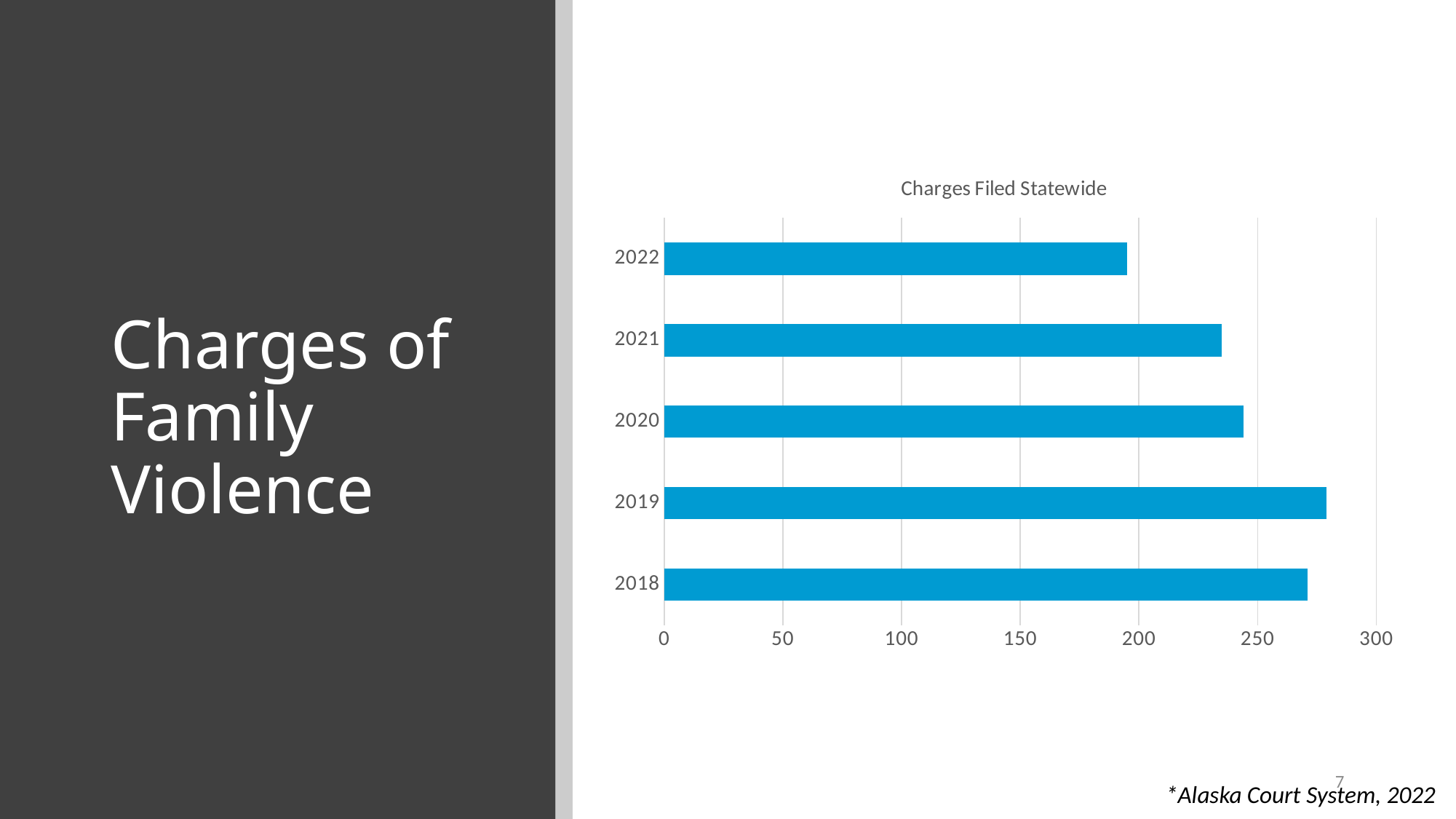
Which year has more charges filed, 2018 or 2021? 2018 Do the charges filed statewide generally rise or fall from 2019 to 2022? fall What is the title of the chart? Charges Filed Statewide Which year has more charges filed, 2019 or 2022? 2019 Is the value for 2019 greater or less than 250? greater Which year has the highest number of charges filed statewide? 2019 Which year has the lowest number of charges filed statewide? 2022 What kind of chart is shown on the slide? bar chart How many years are shown on the chart? 5 Is the value for 2021 greater or less than 200? greater Is the value for 2018 greater or less than 300? less